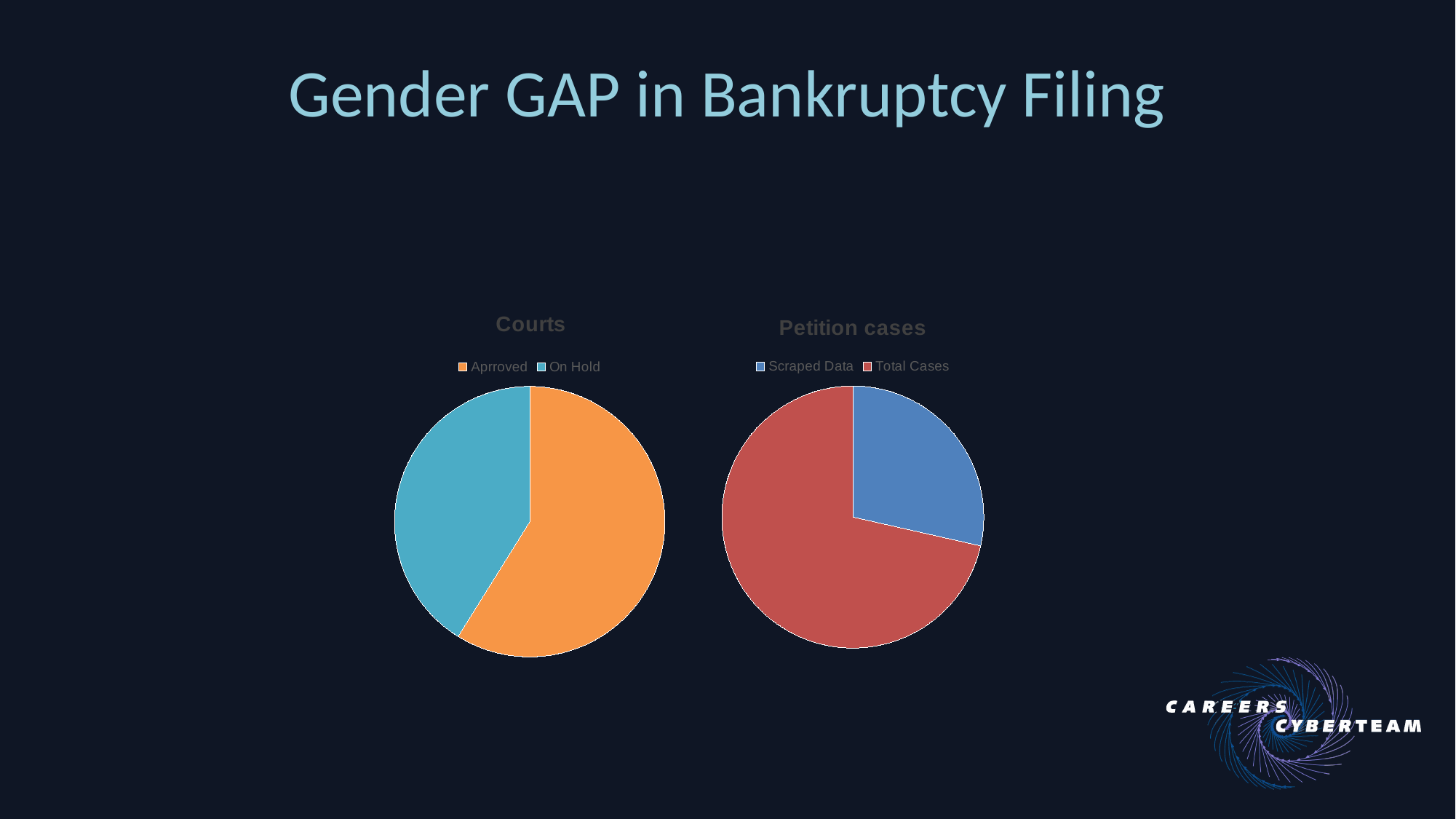
How many entries does the legend of the "Petition cases" chart list? 2 What kind of chart is the "Petition cases" chart? pie chart What is the title of the chart on the right of the slide? Petition cases In the "Courts" chart, which slice is the largest? Aprroved How many slices does the "Courts" chart have? 2 In the "Petition cases" chart, which is larger: Scraped Data or Total Cases? Total Cases What kind of chart is the "Courts" chart? pie chart What colour is the "On Hold" slice in the "Courts" chart? teal blue In the "Petition cases" chart, which slice is the largest? Total Cases In the "Courts" chart, which slice is the smallest? On Hold In the "Petition cases" chart, which slice is the smallest? Scraped Data In the "Courts" chart, which is larger: Aprroved or On Hold? Aprroved